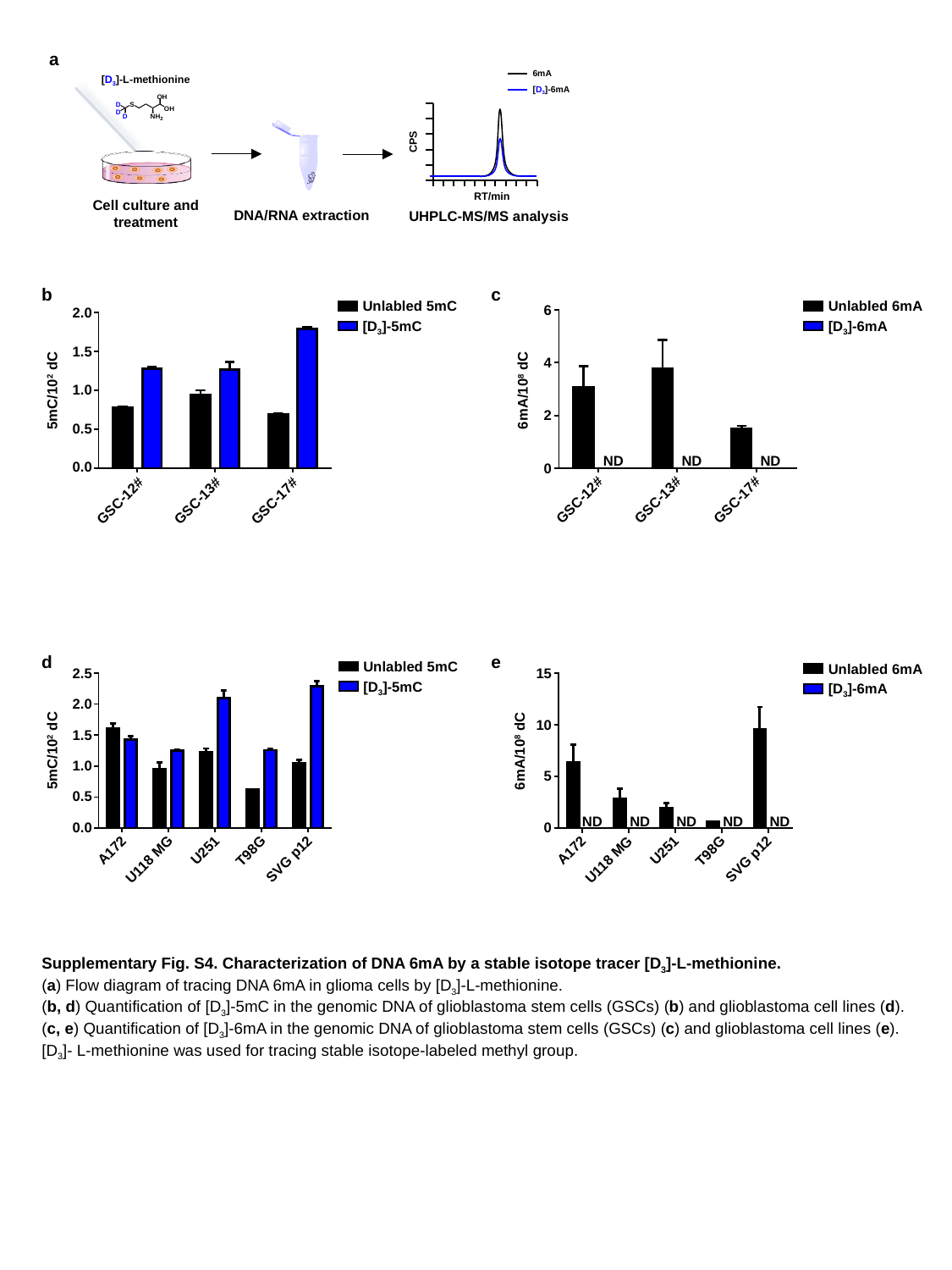
In panel b, how many series does the legend list? 2 In panel d, for A172, which is larger: Unlabled 5mC or [D3]-5mC? Unlabled 5mC In panel d, which cell line has the lowest Unlabled 5mC value? T98G What kind of chart is panel b? bar chart In panel b, is the [D3]-5mC value for GSC-17# greater or less than 1.5? greater In panel c, which cell line has the lowest Unlabled 6mA value? GSC-17# In panel e, which cell line has the highest Unlabled 6mA value? SVG p12 In panel c, is the Unlabled 6mA value for GSC-17# greater or less than 2? less In panel e, is the Unlabled 6mA value for A172 greater or less than 5? greater In panel b, which cell line has the highest [D3]-5mC value? GSC-17# In panel c, what is shown for the [D3]-6mA series for GSC-12#? ND In panel d, how many cell lines are shown on the x axis? 5